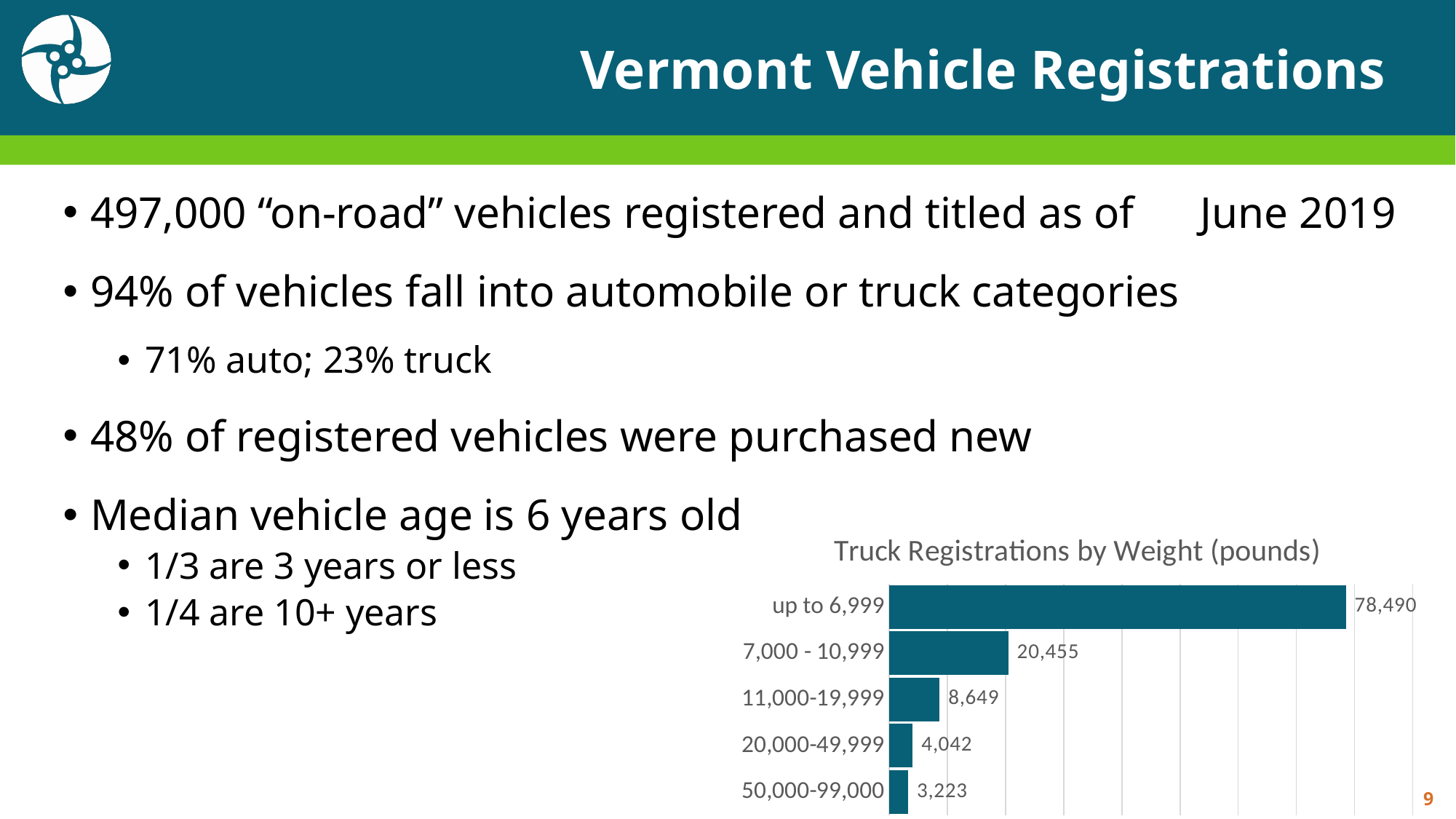
Which weight category has the highest number of truck registrations? up to 6,999 Which has more truck registrations: '11,000-19,999' or '20,000-49,999'? 11,000-19,999 What is the difference between the '20,000-49,999' and '50,000-99,000' categories? 819 What is the value for the 'up to 6,999' weight category in the Truck Registrations by Weight chart? 78,490 Which weight category has the lowest number of truck registrations? 50,000-99,000 What is the value for the '11,000-19,999' category? 8,649 How many truck registrations are shown for the '7,000 - 10,999' weight category? 20,455 What is the value for the '50,000-99,000' category? 3,223 What is the title of the chart on the slide? Truck Registrations by Weight (pounds) How many weight categories are shown in the chart? 5 What kind of chart is used to show Truck Registrations by Weight? Bar chart What is the difference between the 'up to 6,999' and '7,000 - 10,999' categories? 58,035